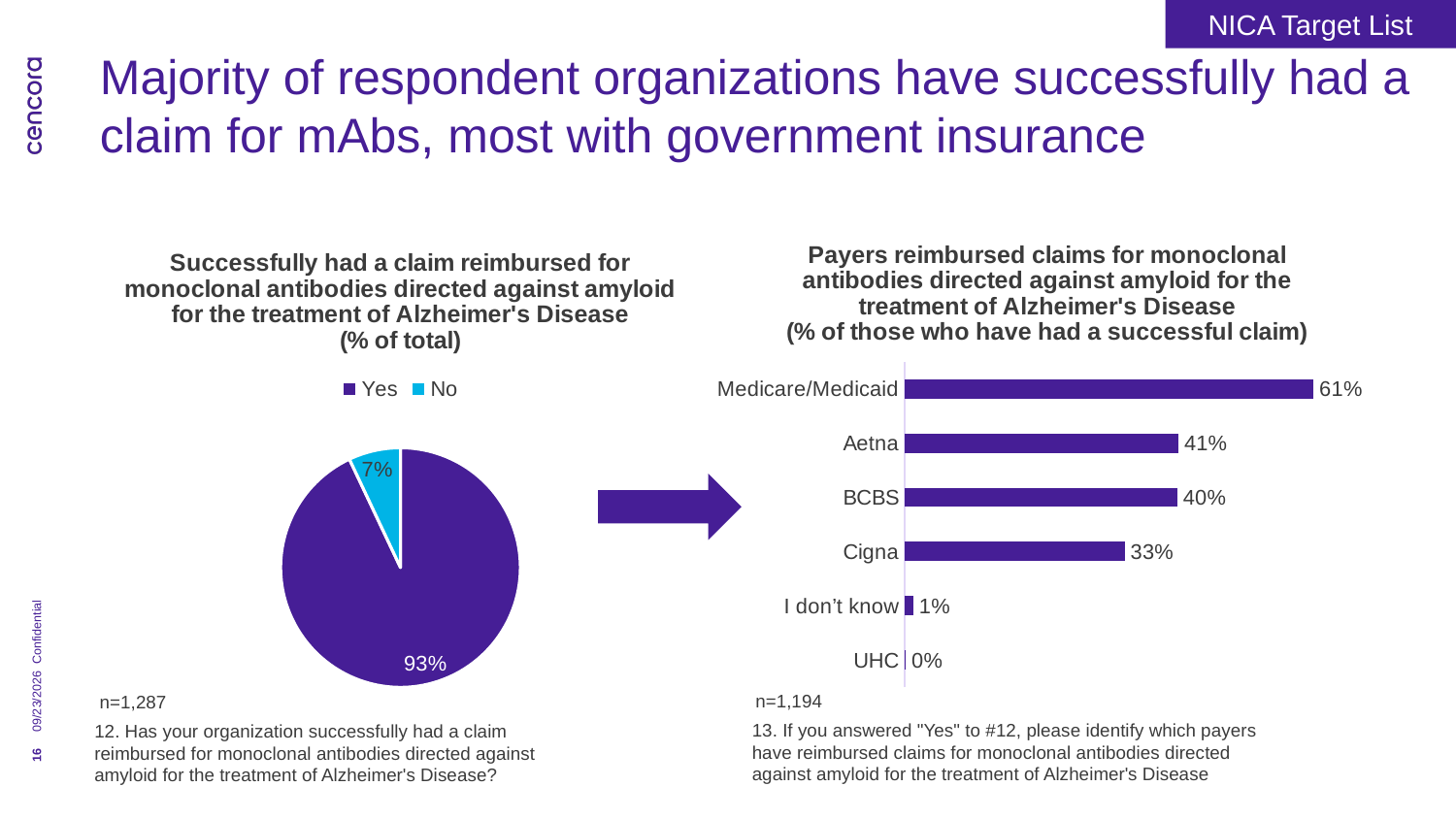
In the bar chart on the right, what is the difference between the values for Medicare/Medicaid and Aetna? 20% In the pie chart on the left, what percentage of respondents answered Yes? 93% In the pie chart on the left, what percentage of respondents answered No? 7% What type of chart is the chart on the left? Pie chart How many payer categories are shown in the bar chart on the right? 6 In the bar chart on the right, what is the value for Medicare/Medicaid? 61% In the bar chart on the right, what is the value for Cigna? 33% In the bar chart on the right, which is larger, the value for Aetna or the value for Cigna? Aetna In the bar chart on the right, which payer has the lowest value? UHC What type of chart is the chart on the right? Bar chart How many entries does the legend of the pie chart on the left list? 2 In the bar chart on the right, which payer has the highest value? Medicare/Medicaid